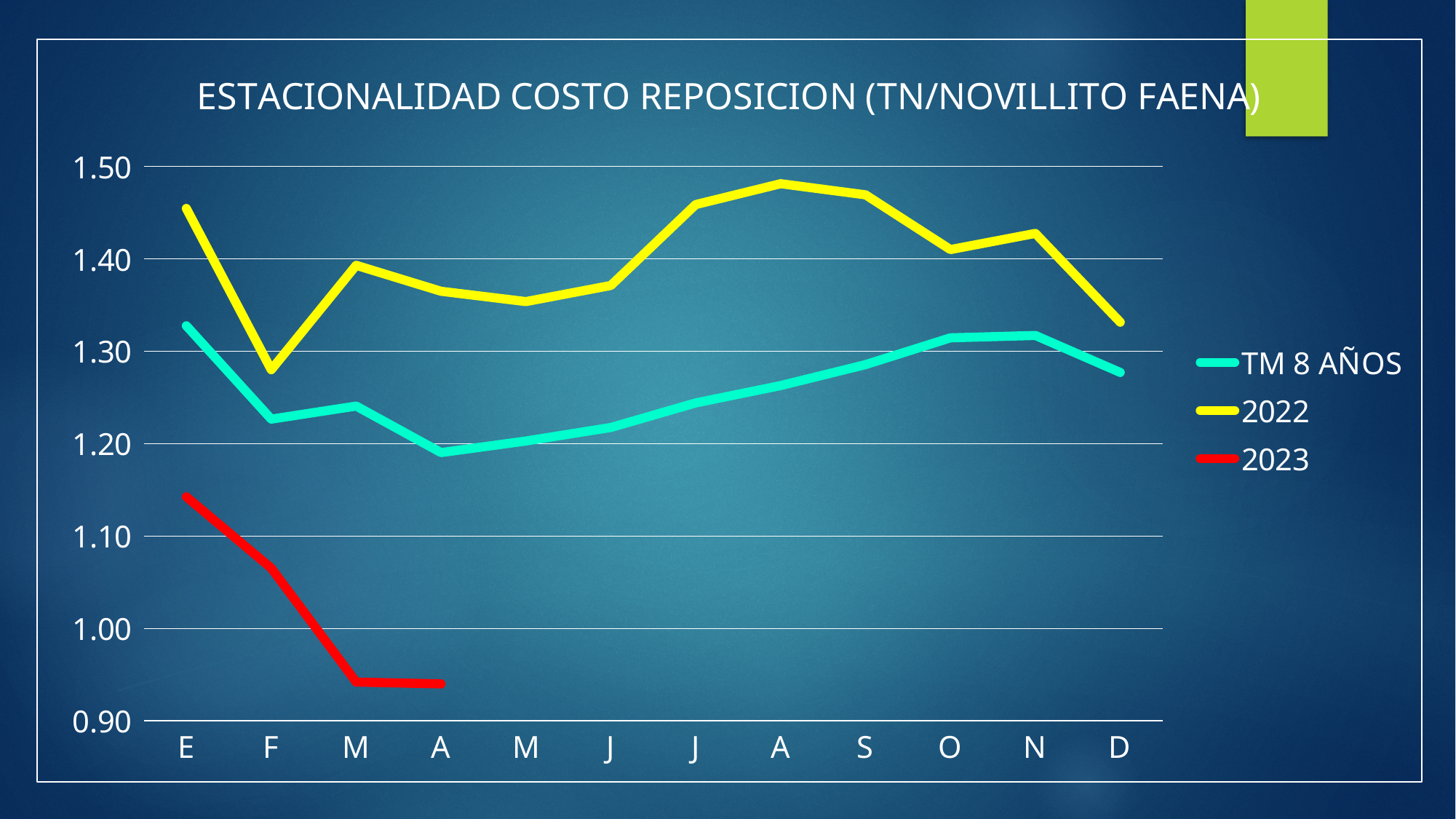
At which x-axis category does the 2022 series reach its lowest value? F At which x-axis category does the TM 8 AÑOS series reach its lowest value? A (the fourth month) Which colour is used for the 2023 series? Red How many categories are shown along the x axis? 12 What is the title of the chart? ESTACIONALIDAD COSTO REPOSICION (TN/NOVILLITO FAENA) Is the value of the 2022 series at E greater or less than 1.40? greater At which x-axis category does the 2022 series reach its highest value? A (the eighth month) At E, which series has the larger value: 2022 or TM 8 AÑOS? 2022 How many series does the legend list? 3 Does the 2023 series rise or fall from E to the first M? Fall Is the value of the 2023 series at the first M (third month) greater or less than 1.00? less What kind of chart is shown on the slide? Line chart